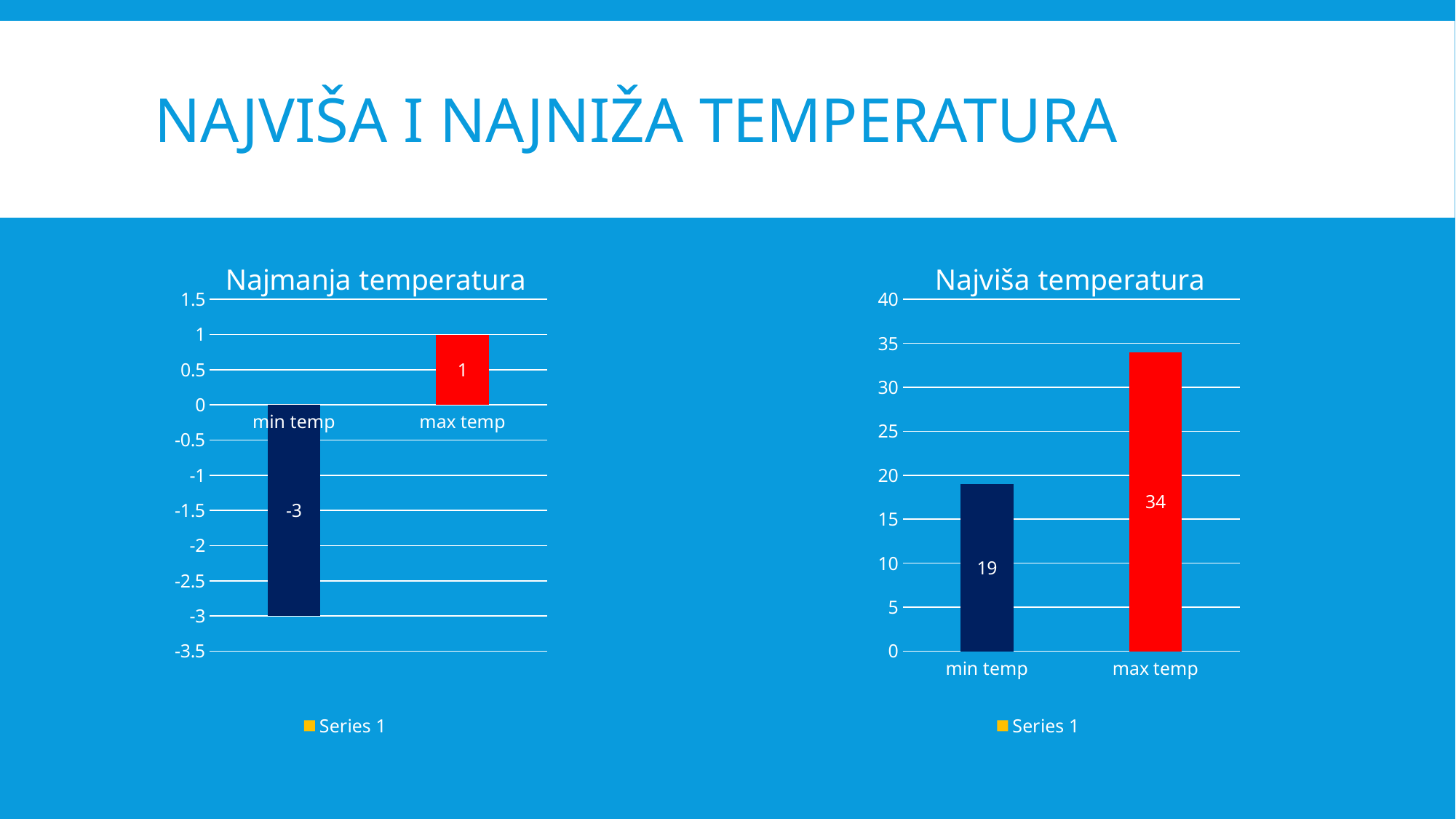
In the 'Najviša temperatura' chart, what is the difference between max temp and min temp? 15 In the 'Najmanja temperatura' chart, which category has the lowest value? min temp In the 'Najmanja temperatura' chart, what is the value for min temp? -3 In the 'Najviša temperatura' chart, what is the value for min temp? 19 In the 'Najmanja temperatura' chart, what is the difference between max temp and min temp? 4 What series name does the legend of the 'Najviša temperatura' chart list? Series 1 In the 'Najviša temperatura' chart, what is the value for max temp? 34 In the 'Najviša temperatura' chart, is the value for min temp greater or less than 20? less In the 'Najviša temperatura' chart, which category has the highest value? max temp In the 'Najmanja temperatura' chart, what is the value for max temp? 1 How many categories does the 'Najviša temperatura' chart show? 2 What kind of chart is the 'Najmanja temperatura' chart? bar chart